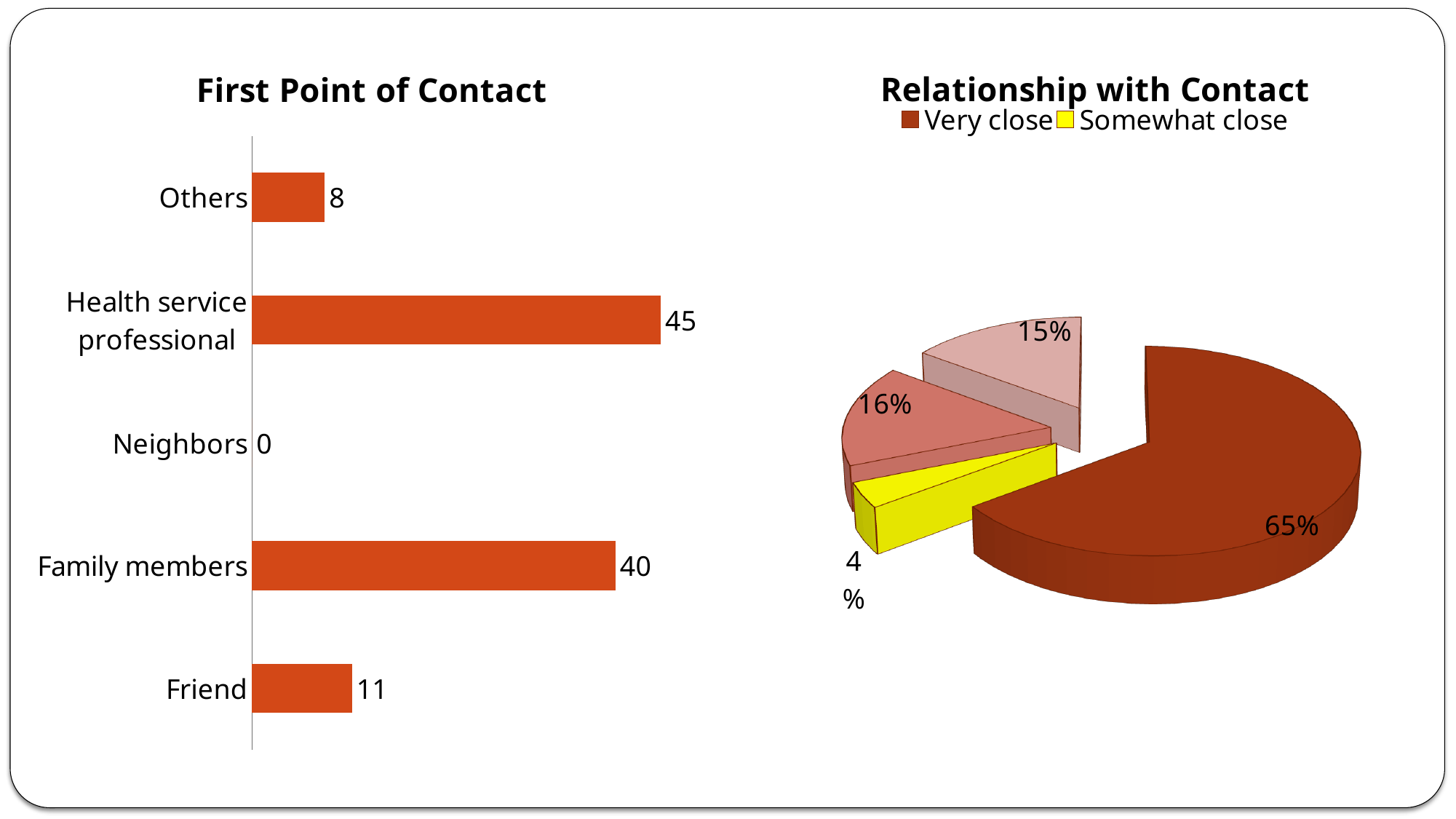
In the First Point of Contact chart, what is the value for Family members? 40 In the First Point of Contact chart, what is the difference between Health service professional and Family members? 5 In the Relationship with Contact chart, what share of the pie is Somewhat close? 4% In the First Point of Contact chart, which category has the highest value? Health service professional In the First Point of Contact chart, what is the value for Health service professional? 45 In the First Point of Contact chart, which is larger, Friend or Others? Friend In the Relationship with Contact chart, what share of the pie is Very close? 65% What kind of chart is the First Point of Contact chart? Bar chart In the First Point of Contact chart, what is the value for Friend? 11 What kind of chart is the Relationship with Contact chart? Pie chart In the First Point of Contact chart, which category has the lowest value? Neighbors How many categories are shown in the First Point of Contact chart? 5